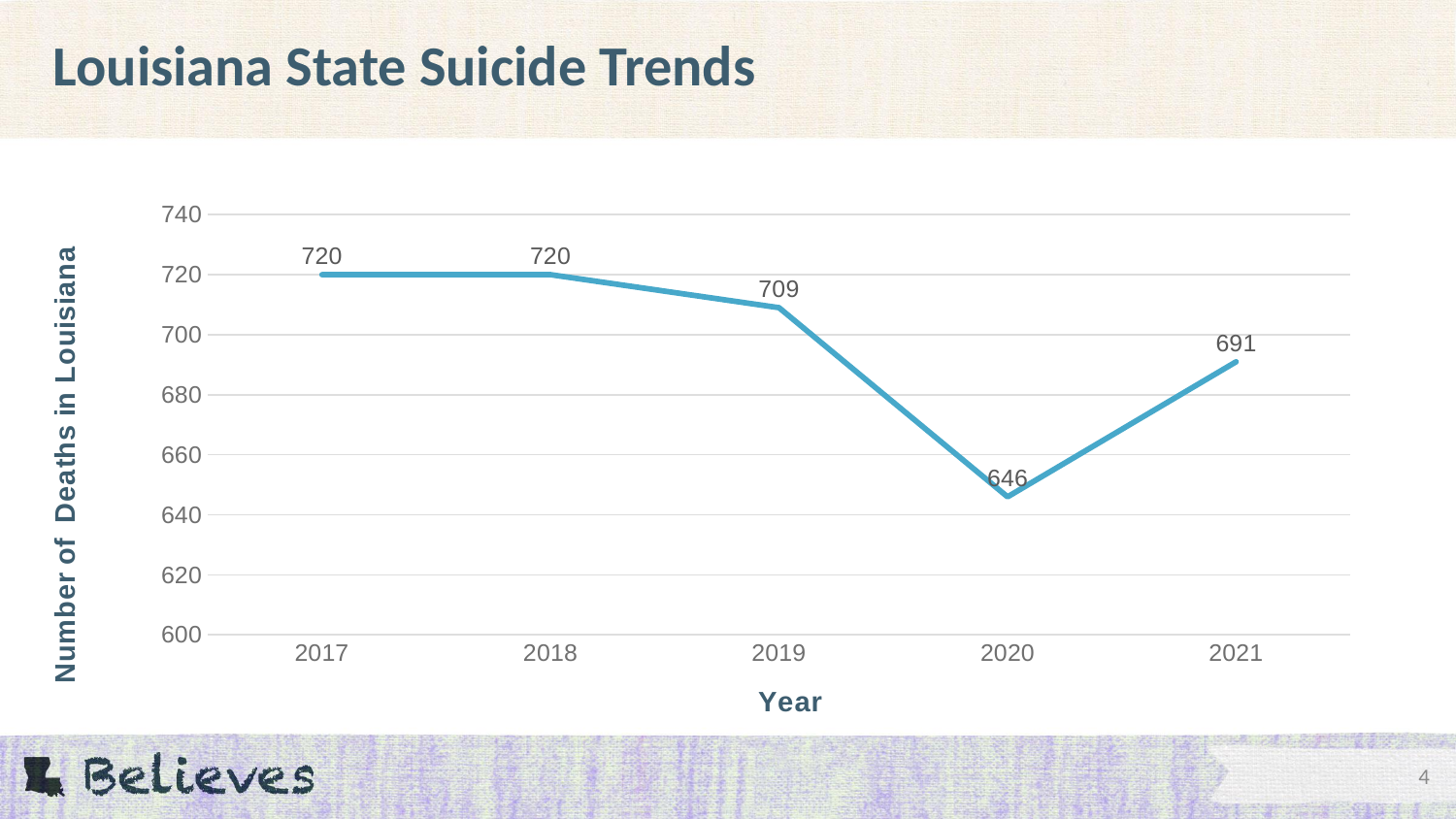
What kind of chart is shown on the slide? line chart What is the difference in the number of deaths between 2021 and 2020? 45 How many years are plotted on the chart? 5 What is the difference in the number of deaths between 2019 and 2020? 63 What is the number of deaths in Louisiana for 2021? 691 Which year has more deaths, 2019 or 2021? 2019 Is the value for 2020 greater or less than 660? less Which year has the lowest number of deaths? 2020 Do the values rise or fall from 2018 to 2020? fall What is the number of deaths in Louisiana for 2019? 709 What is the number of deaths in Louisiana for 2020? 646 What is the label of the y axis? Number of Deaths in Louisiana